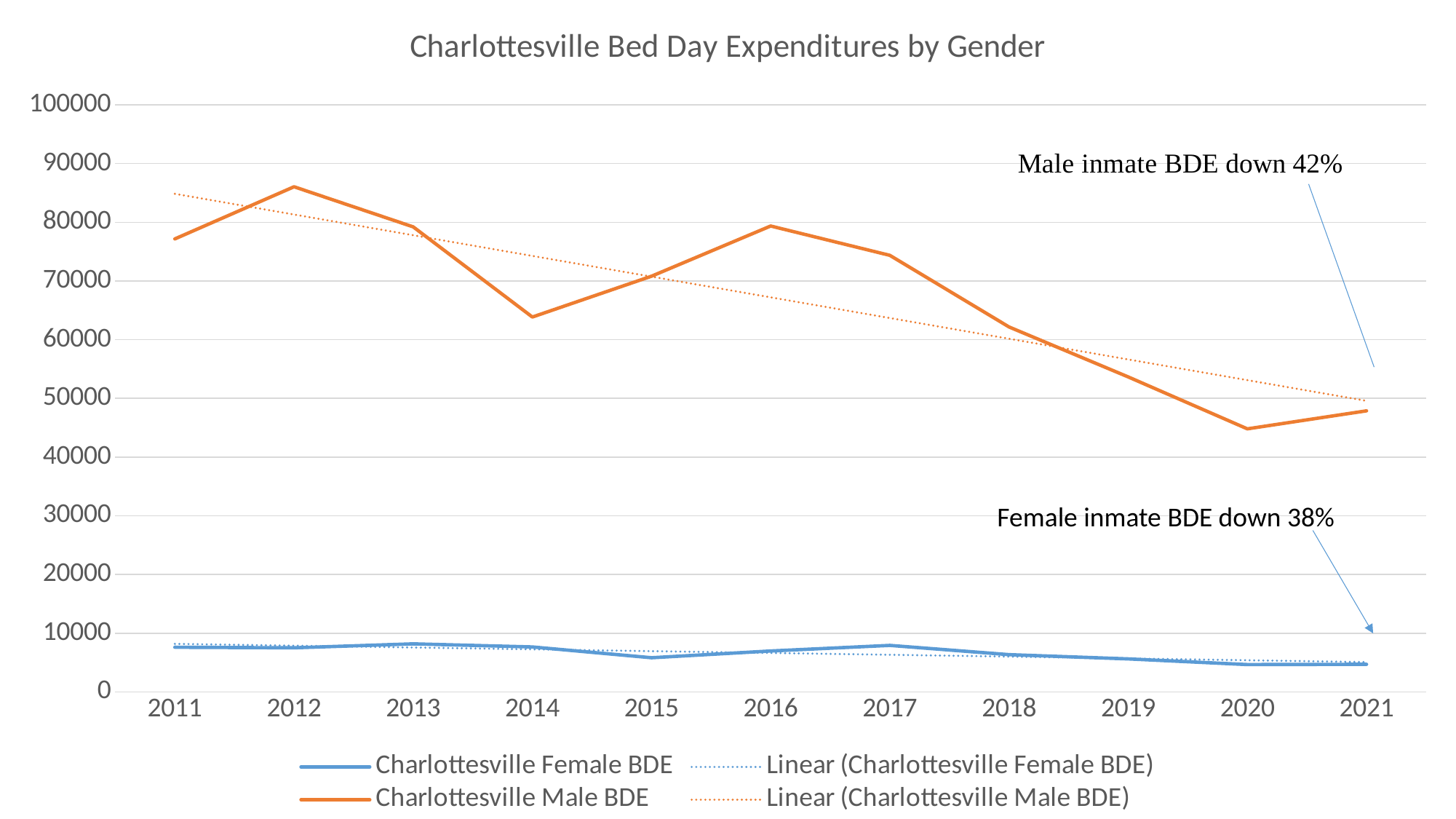
What type of chart is shown on the slide? Line chart Is the value for Charlottesville Female BDE in 2015 greater or less than 10000? less How many years are shown on the x axis? 11 Which is larger: Charlottesville Male BDE in 2016 or in 2018? 2016 What is the title of the chart? Charlottesville Bed Day Expenditures by Gender In which year is Charlottesville Male BDE highest? 2012 How many entries does the legend list? 4 Does Charlottesville Male BDE generally rise or fall from 2011 to 2021? Fall Is the value for Charlottesville Male BDE in 2014 greater or less than 70000? less Is the value for Charlottesville Male BDE in 2012 greater or less than 80000? greater In which year is Charlottesville Male BDE lowest? 2020 According to the annotation on the chart, by what percentage is male inmate BDE down? 42%